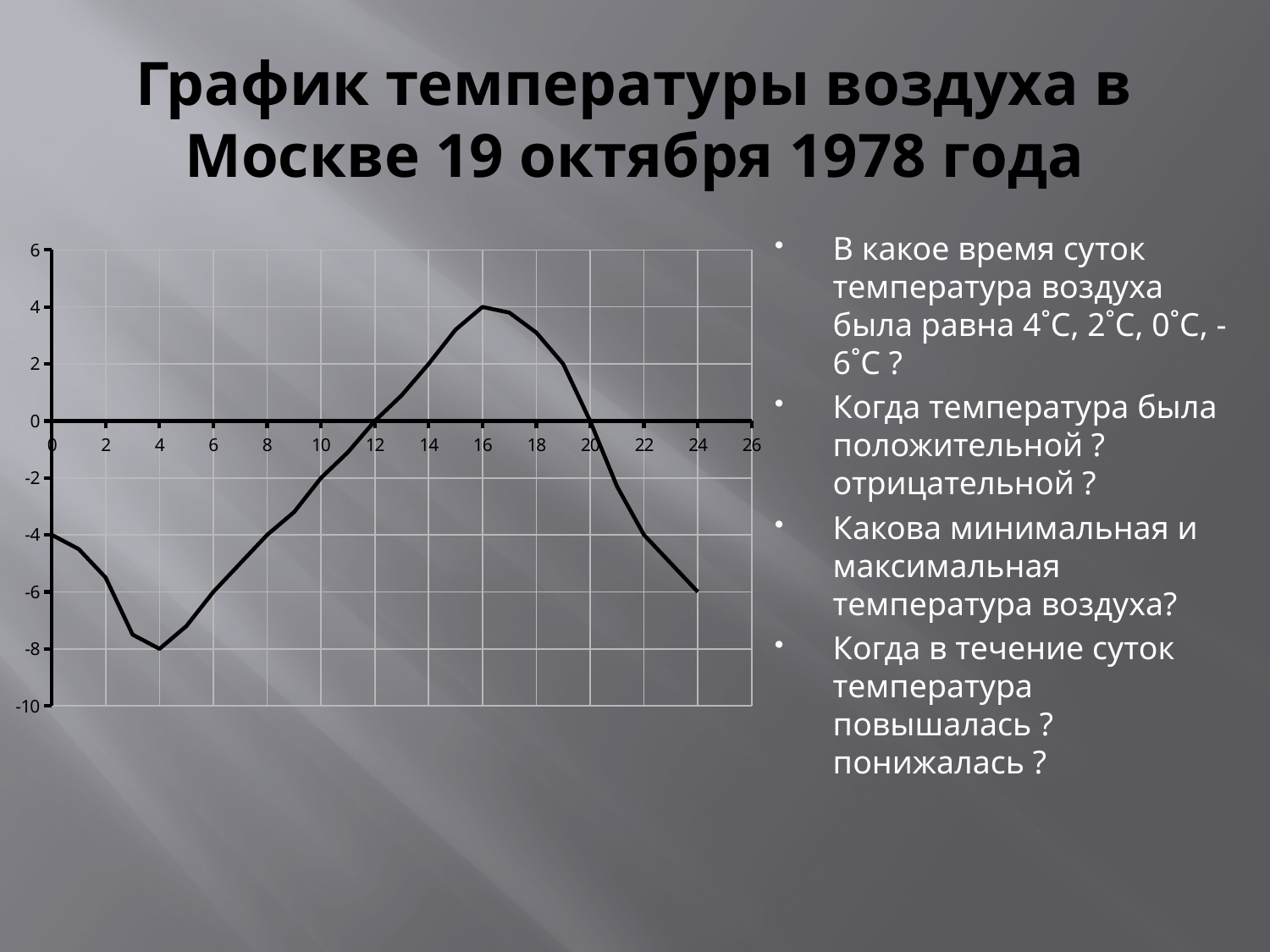
What kind of chart is shown on the slide? line chart What is the minimum temperature shown on the chart? -8 Does the temperature rise or fall between hour 4 and hour 16? rise Is the temperature at hour 8 greater or less than -2? less What is the title of the chart on the slide? График температуры воздуха в Москве 19 октября 1978 года What is the difference between the maximum and minimum temperatures on the chart? 12 At what hour does the temperature reach its minimum? 4 Is the temperature at hour 18 greater or less than 2? greater What is the maximum temperature shown on the chart? 4 What is the temperature at hour 0? -4 At what hour does the temperature reach its maximum? 16 What is the temperature at hour 24? -6